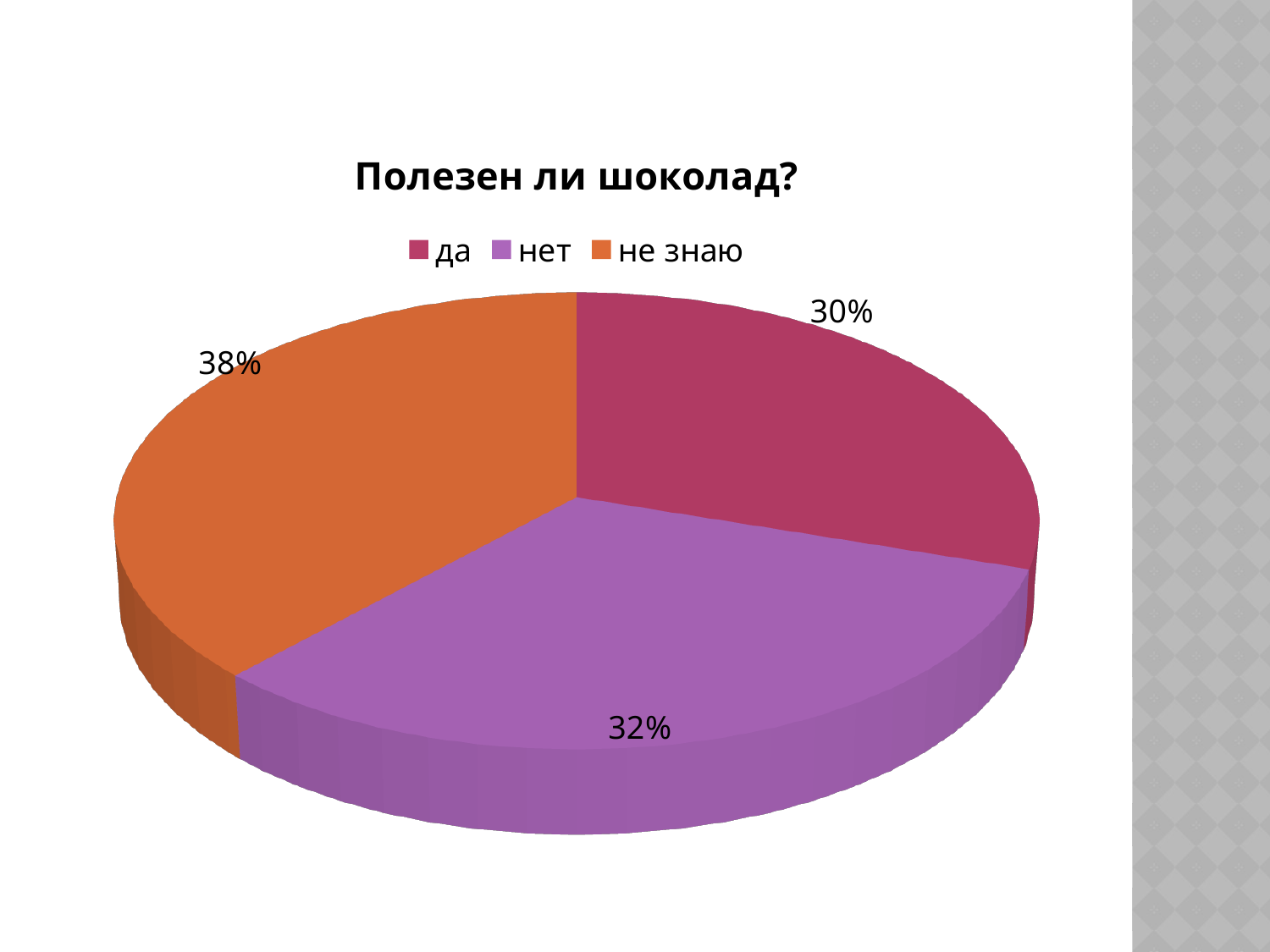
Which colour represents the 'не знаю' category? orange How many categories does the pie chart have? 3 What share of the pie does the 'да' slice represent? 30% Which category has the largest slice? не знаю What is the title of the chart? Полезен ли шоколад? What is the difference between the 'не знаю' share and the 'да' share? 8% What is the difference between the 'нет' share and the 'да' share? 2% Which category has the smallest slice? да How many entries does the legend list? 3 What share of the pie does the 'не знаю' slice represent? 38% What share of the pie does the 'нет' slice represent? 32% What kind of chart is shown on the slide? pie chart